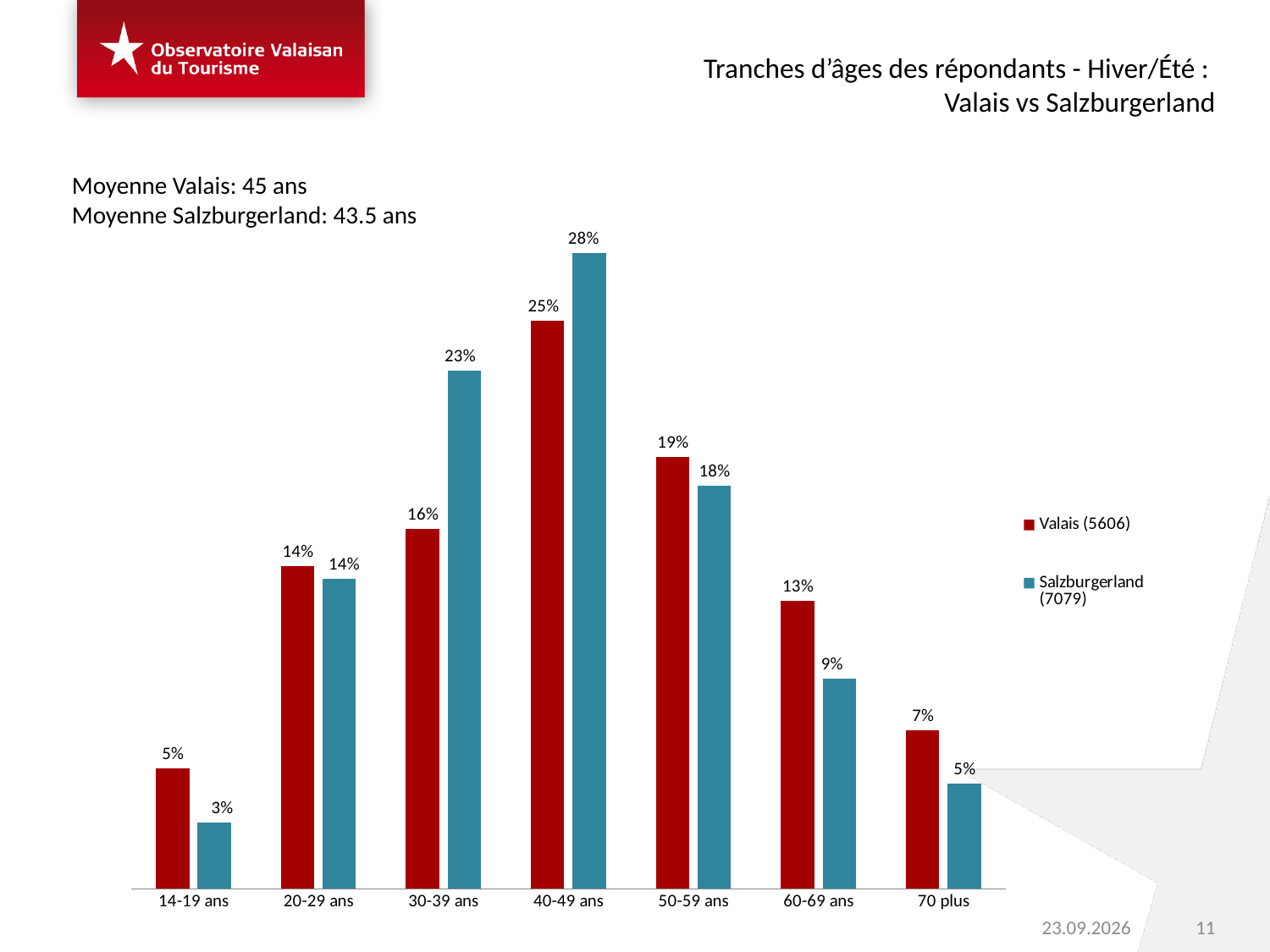
How many series does the legend list? 2 What is the value for Valais in the 40-49 ans age group? 25% What is the value for Salzburgerland in the 14-19 ans age group? 3% What kind of chart is shown on the slide? Bar chart What is the difference between the Salzburgerland and Valais values in the 40-49 ans age group? 3% What is the value for Salzburgerland in the 30-39 ans age group? 23% What is the legend entry for the blue series? Salzburgerland (7079) Which age group has the highest value for Salzburgerland? 40-49 ans In the 50-59 ans age group, which series has the larger value, Valais or Salzburgerland? Valais Which age group has the lowest value for Valais? 14-19 ans How many age groups are shown on the x axis? 7 What is the difference between the Valais and Salzburgerland values in the 60-69 ans age group? 4%